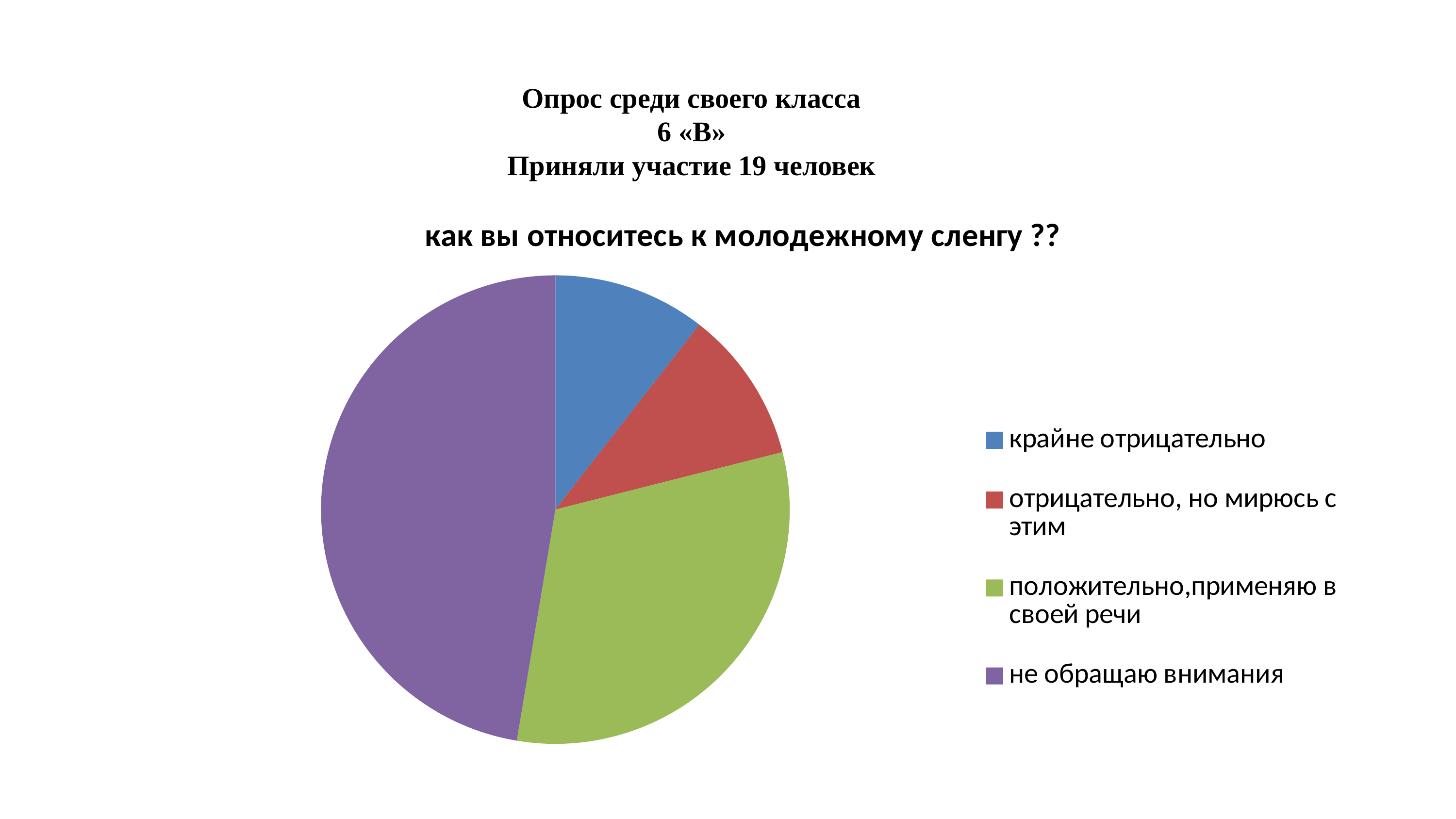
Which slice is larger: "положительно,применяю в своей речи" or "отрицательно, но мирюсь с этим"? положительно,применяю в своей речи Which slice is larger: "не обращаю внимания" or "отрицательно, но мирюсь с этим"? не обращаю внимания How many categories (slices) does the pie chart have? 4 Which category has the largest slice of the pie chart? не обращаю внимания Which slice is larger: "не обращаю внимания" or "положительно,применяю в своей речи"? не обращаю внимания What is the title of the pie chart? как вы относитесь к молодежному сленгу ?? What kind of chart is shown on the slide? pie chart Which colour represents "не обращаю внимания" in the pie chart? purple